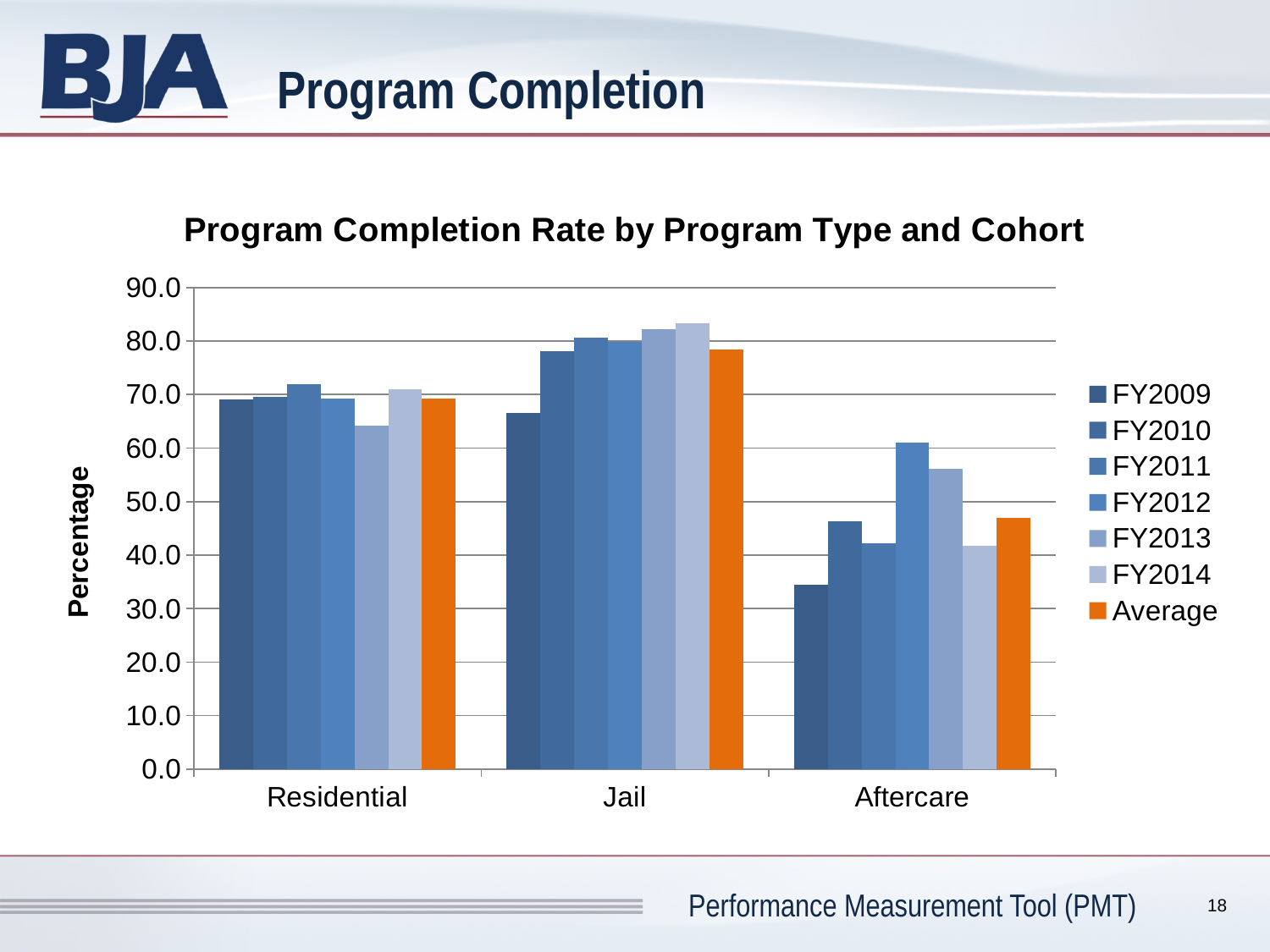
Is the Average value for Aftercare greater or less than 50.0? less Which program type has the lowest FY2009 completion rate? Aftercare Is the FY2013 value for Residential greater or less than 60.0? greater Is the FY2009 value for Aftercare greater or less than 40.0? less Within the Aftercare group, which cohort has the highest completion rate? FY2012 What is the label on the y axis? Percentage How many series does the legend list? 7 How many program types are shown on the x axis? 3 Which program type has the highest Average completion rate? Jail Which program type has the higher Average completion rate, Jail or Aftercare? Jail What kind of chart is shown on the slide? bar chart